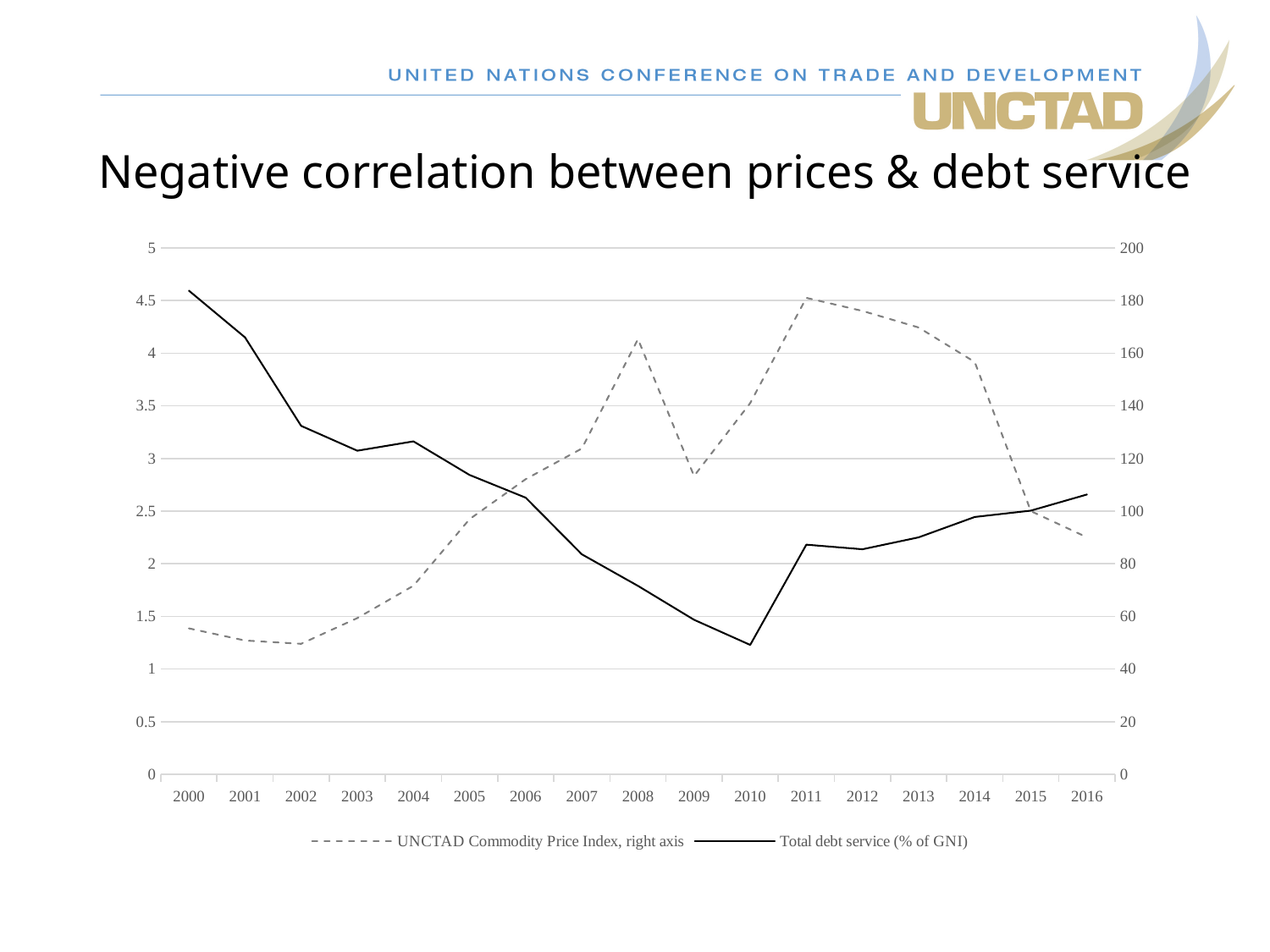
In which year does the UNCTAD Commodity Price Index reach its highest value? 2011 How many series does the legend list? 2 Is the value for Total debt service (% of GNI) in 2000 greater or less than 4? greater In which year is Total debt service (% of GNI) lowest? 2010 Is the value for Total debt service (% of GNI) in 2010 greater or less than 1.5? less Which is larger: Total debt service (% of GNI) in 2001 or in 2011? 2001 Does Total debt service (% of GNI) rise or fall from 2000 to 2010? fall What kind of chart is shown on the slide? line chart Is the UNCTAD Commodity Price Index in 2004 greater or less than 80? less Which axis is the UNCTAD Commodity Price Index plotted against? right axis In which year is Total debt service (% of GNI) highest? 2000 How many years are shown on the x axis? 17